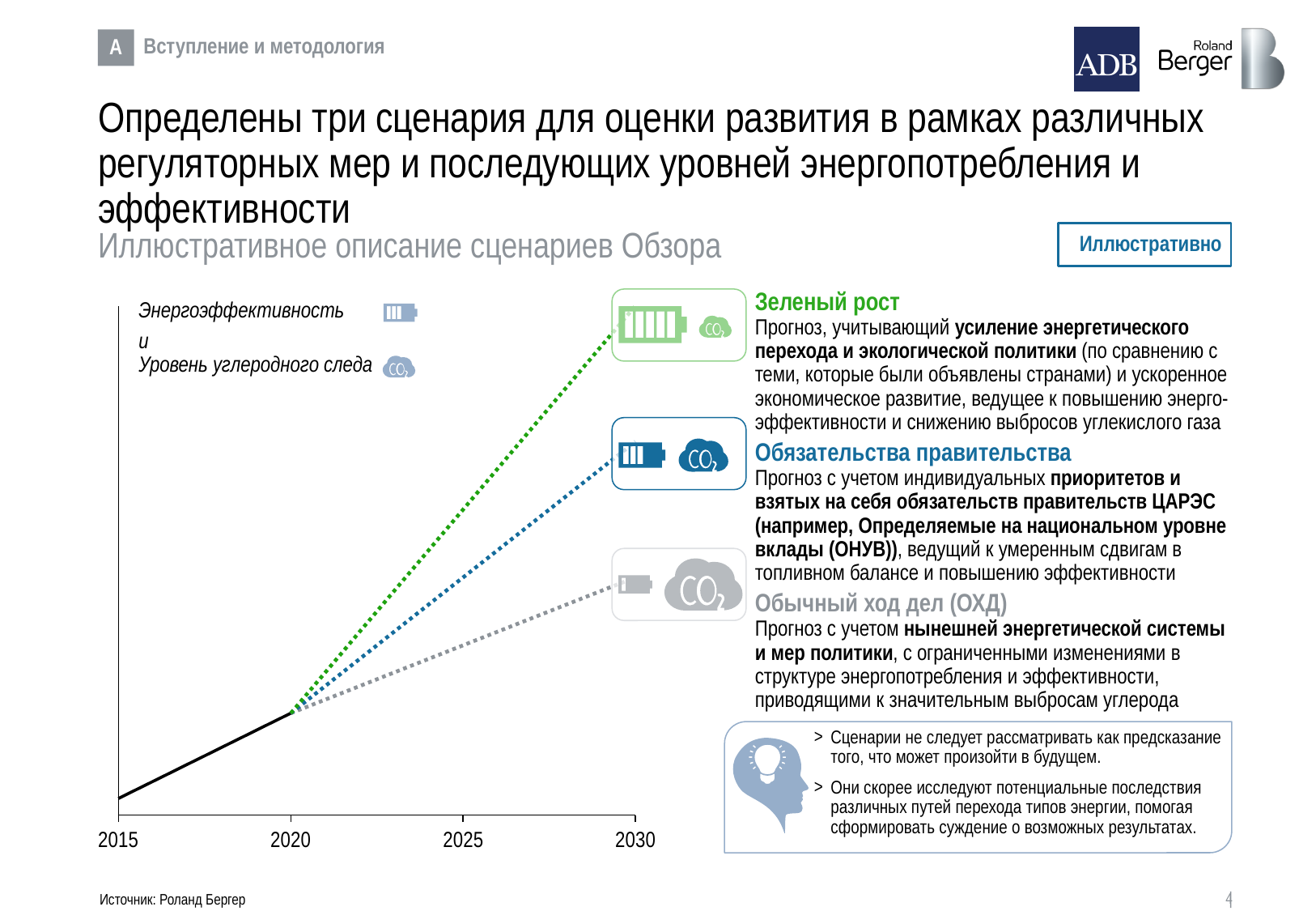
How many scenario lines branch off from the solid black line on the chart? 3 What is the subtitle describing the chart on the slide? Иллюстративное описание сценариев Обзора Which scenario line reaches the highest level by 2030? Зеленый рост Do the scenario lines rise or fall from 2020 to 2030? rise What is the first year shown on the x axis of the chart? 2015 What is the last year shown on the x axis of the chart? 2030 Which scenario line is higher at 2030: Обязательства правительства or Обычный ход дел (ОХД)? Обязательства правительства What kind of chart is shown on the slide? line chart What colour is the dotted line for the Зеленый рост scenario? green Which scenario line reaches the lowest level by 2030? Обычный ход дел (ОХД) How many year labels are shown on the x axis of the chart? 4 At which year on the x axis do the three dotted scenario lines diverge from the solid line? 2020